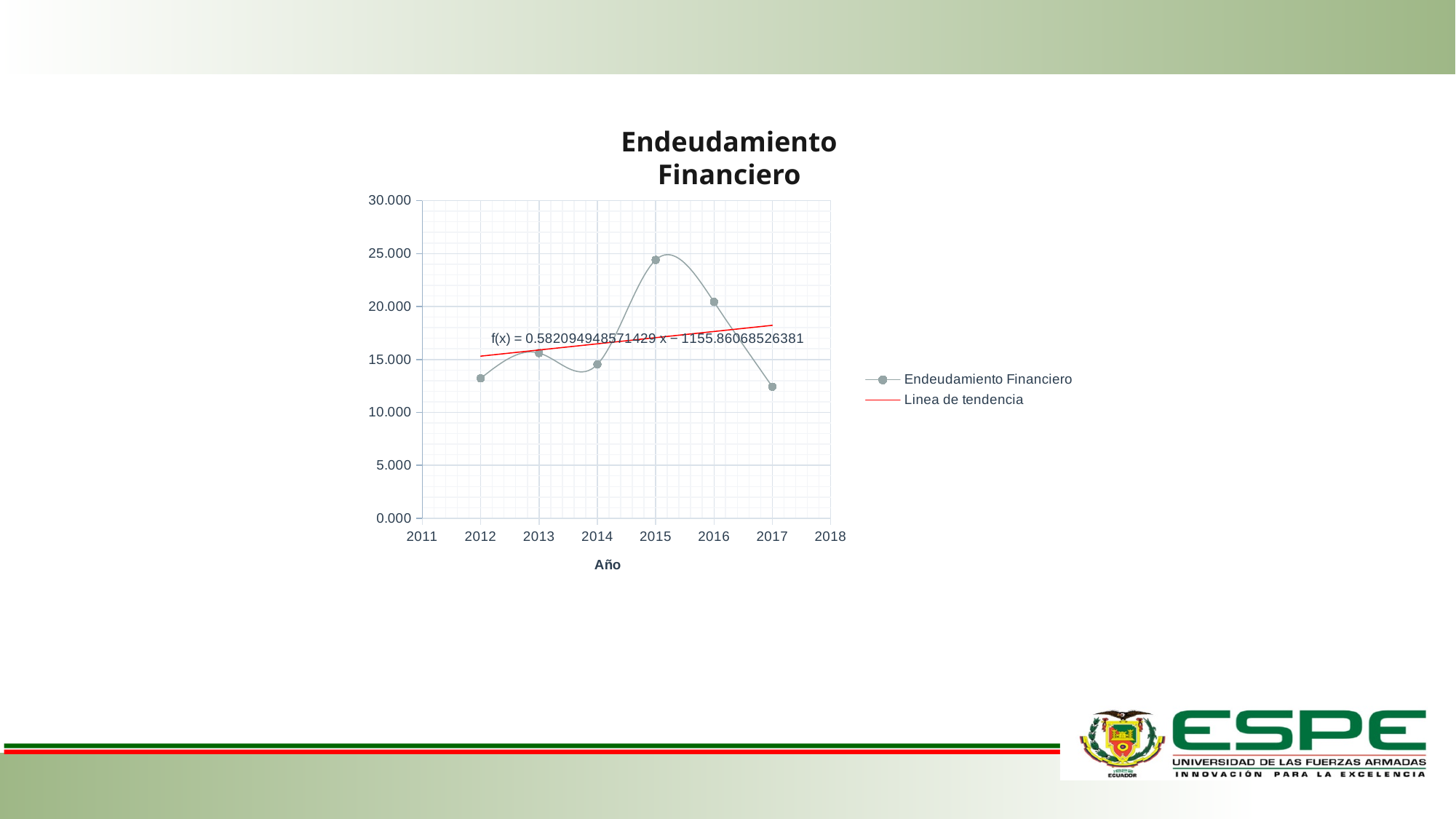
Does Endeudamiento Financiero rise or fall from 2015 to 2017? fall What is the label of the x axis? Año What is the title of the chart? Endeudamiento Financiero In which year is Endeudamiento Financiero lowest? 2017 Is the value for 2012 greater or less than 15.000? less How many data points are plotted for Endeudamiento Financiero? 6 Which year has a higher value, 2013 or 2016? 2016 How many entries does the legend list? 2 Is the value for 2015 greater or less than 20.000? greater In which year is Endeudamiento Financiero highest? 2015 What kind of chart is shown on the slide? line chart